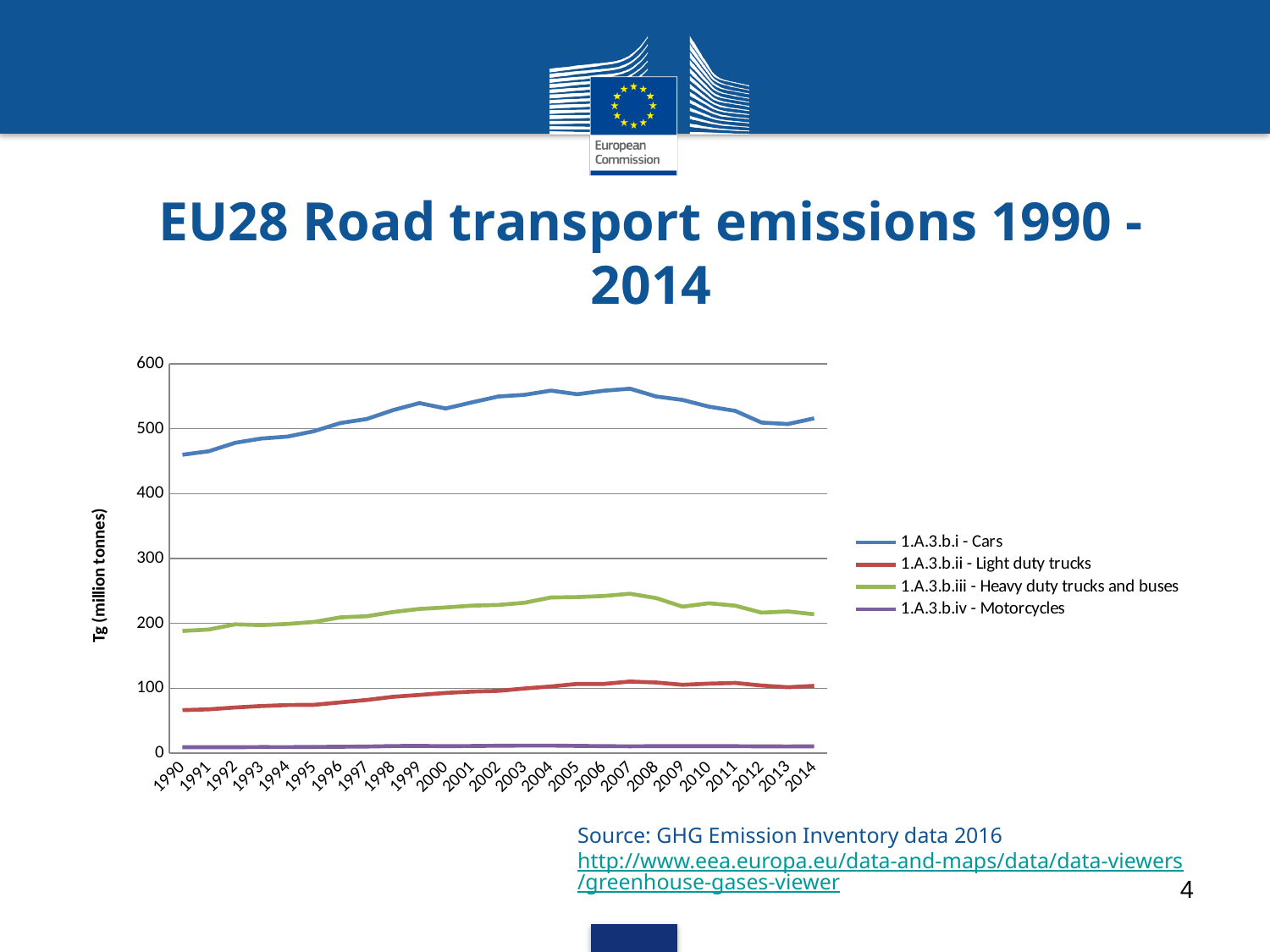
How many series does the legend list? 4 Is the value for Light duty trucks in 1990 greater or less than 100? less Do Cars emissions rise or fall between 2007 and 2014? fall What is the label on the y axis? Tg (million tonnes) In 2014, which is larger: the value for Cars or the value for Heavy duty trucks and buses? Cars Is the value for Heavy duty trucks and buses in 1990 greater or less than 200? less How many years are plotted along the x axis? 25 What kind of chart is shown on the slide? line chart Is the value for Cars in 2007 greater or less than 500? greater Which series has the lowest emissions across the whole period? 1.A.3.b.iv - Motorcycles Which series has the highest emissions across the whole period? 1.A.3.b.i - Cars